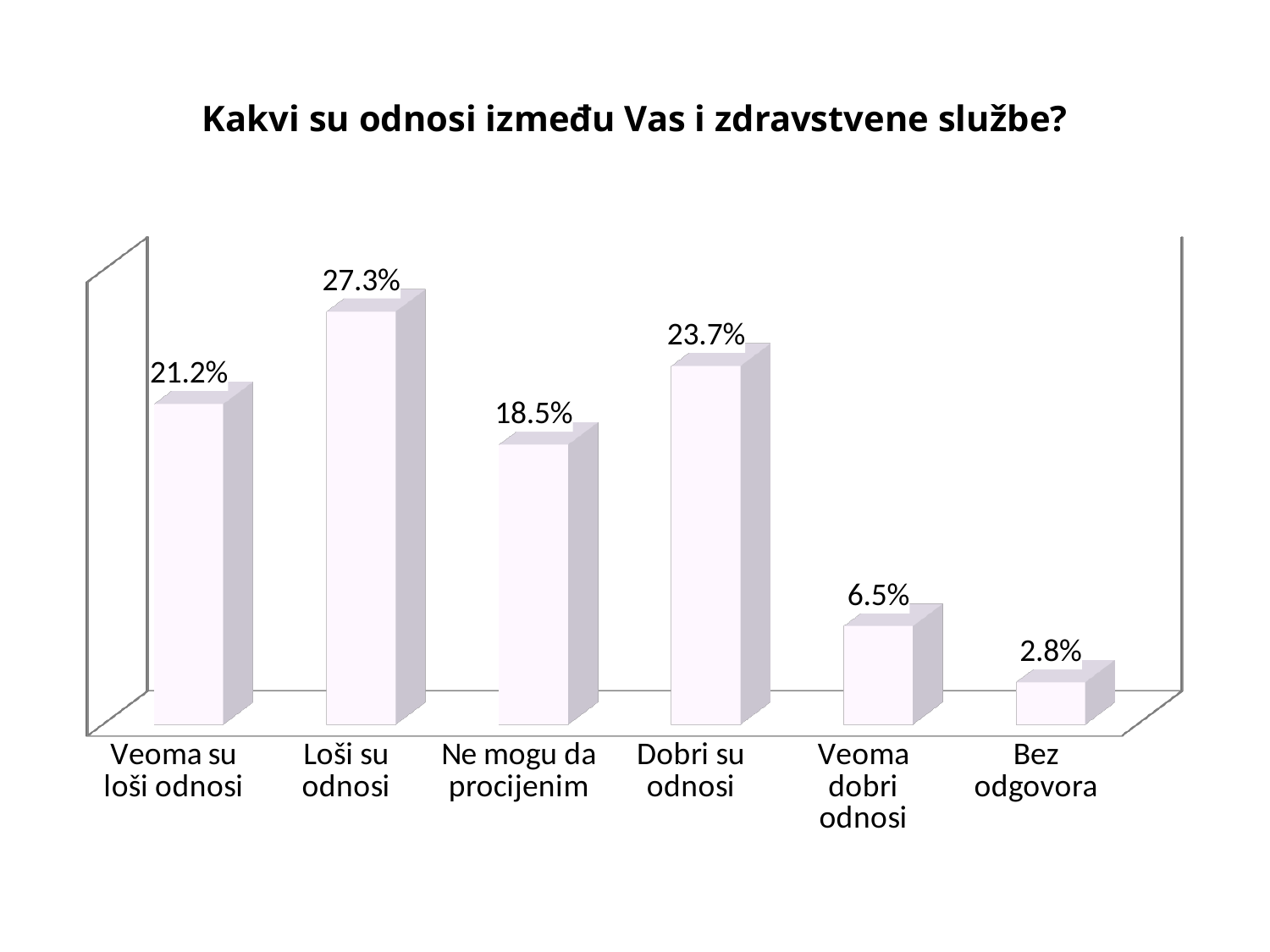
How many categories are shown in the chart? 6 What is the value for "Ne mogu da procijenim"? 18.5% Which is larger, "Veoma dobri odnosi" or "Ne mogu da procijenim"? Ne mogu da procijenim What is the title of the chart? Kakvi su odnosi između Vas i zdravstvene službe? What is the difference between "Loši su odnosi" and "Dobri su odnosi"? 3.6% What is the difference between "Veoma su loši odnosi" and "Bez odgovora"? 18.4% Which category has the lowest value? Bez odgovora Which is larger, "Dobri su odnosi" or "Veoma su loši odnosi"? Dobri su odnosi What is the value for "Veoma dobri odnosi"? 6.5% What kind of chart is shown on the slide? Bar chart What is the value for "Loši su odnosi"? 27.3% Which category has the highest value? Loši su odnosi